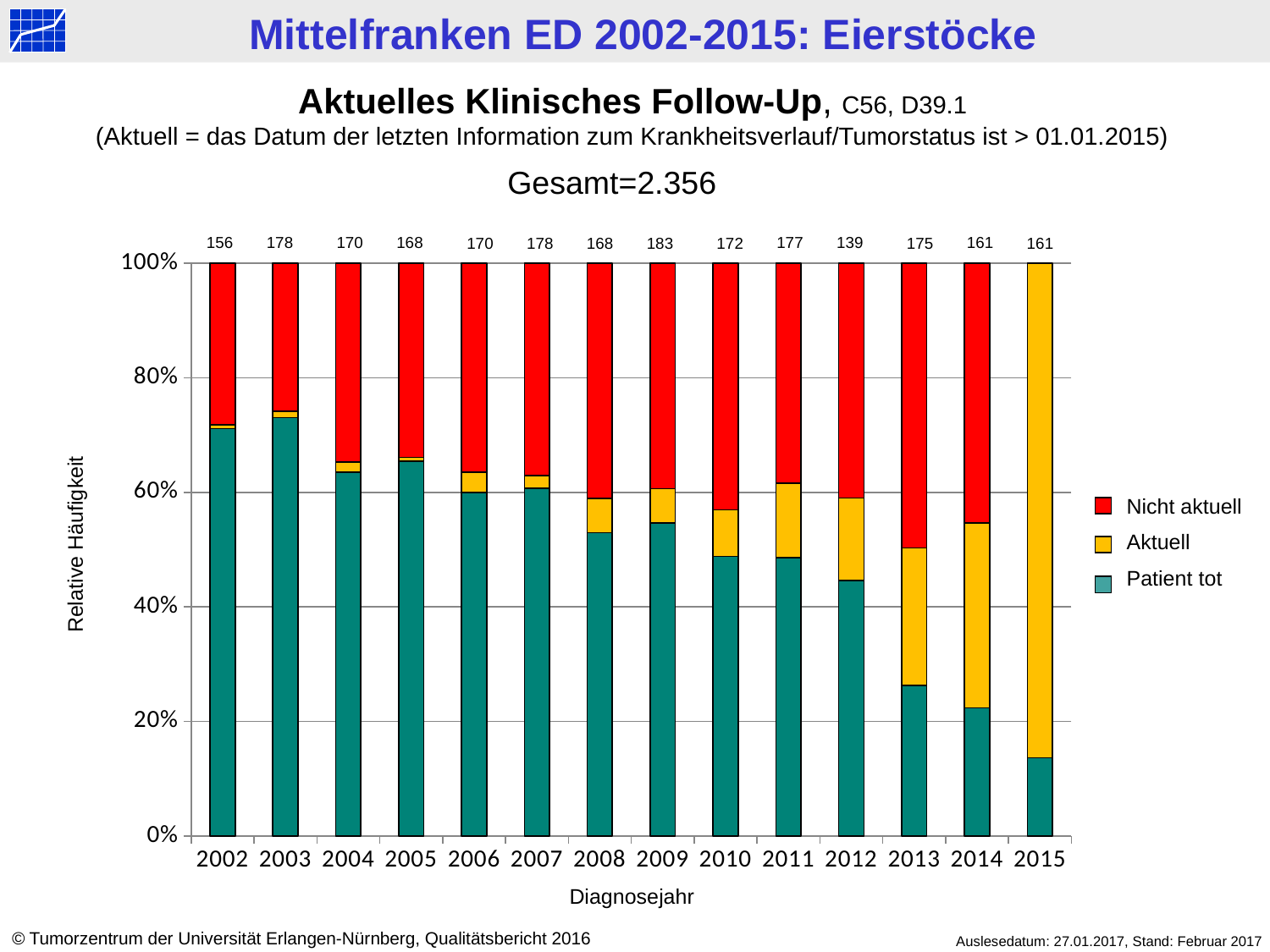
What is the difference between the numbers printed above the bars for 2009 and 2012? 44 Which diagnosis year has the lowest number printed above its bar? 2012 How many diagnosis years are shown on the x axis? 14 Which has the larger number printed above its bar, 2003 or 2004? 2003 What is the number printed above the bar for 2012? 139 Is the 'Patient tot' share for 2015 greater or less than 20%? less What is the number printed above the bar for 2009? 183 What kind of chart is shown on the slide? stacked bar chart Does the 'Patient tot' share generally rise or fall from 2002 to 2015? fall How many series does the legend list? 3 Is the 'Patient tot' share for 2002 greater or less than 60%? greater Which diagnosis year has the highest number printed above its bar? 2009